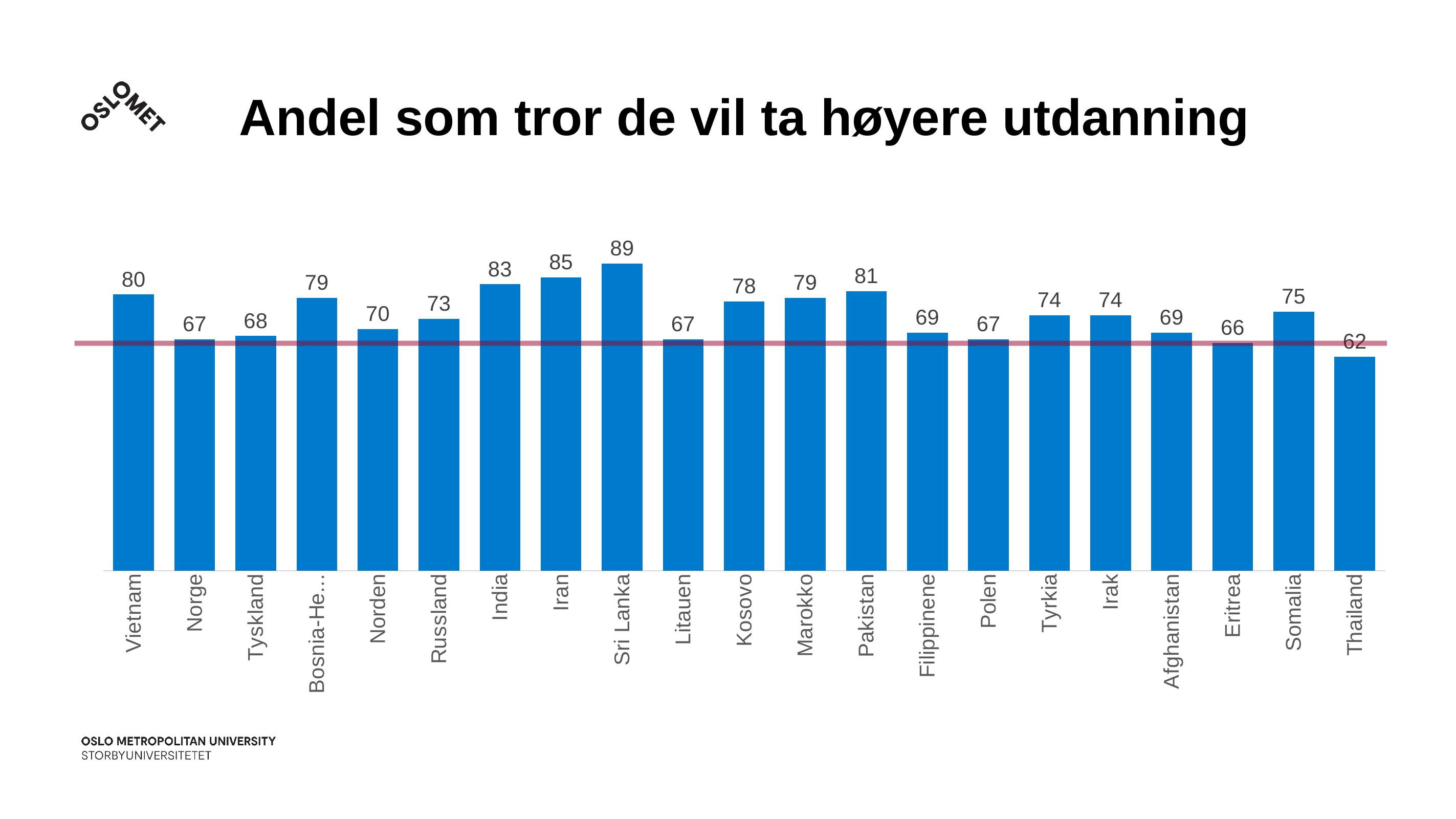
What is the value for Pakistan? 81 What is the value for Sri Lanka? 89 Which is larger, the value for India or the value for Kosovo? India What kind of chart is shown on the slide? Bar chart What is the difference between the values for Vietnam and Norge? 13 Which country has the highest value? Sri Lanka What is the value for Thailand? 62 What is the value for Norge? 67 How many countries are shown in the chart? 21 What is the title of the chart? Andel som tror de vil ta høyere utdanning Which country has the lowest value? Thailand What is the difference between the values for Iran and Eritrea? 19